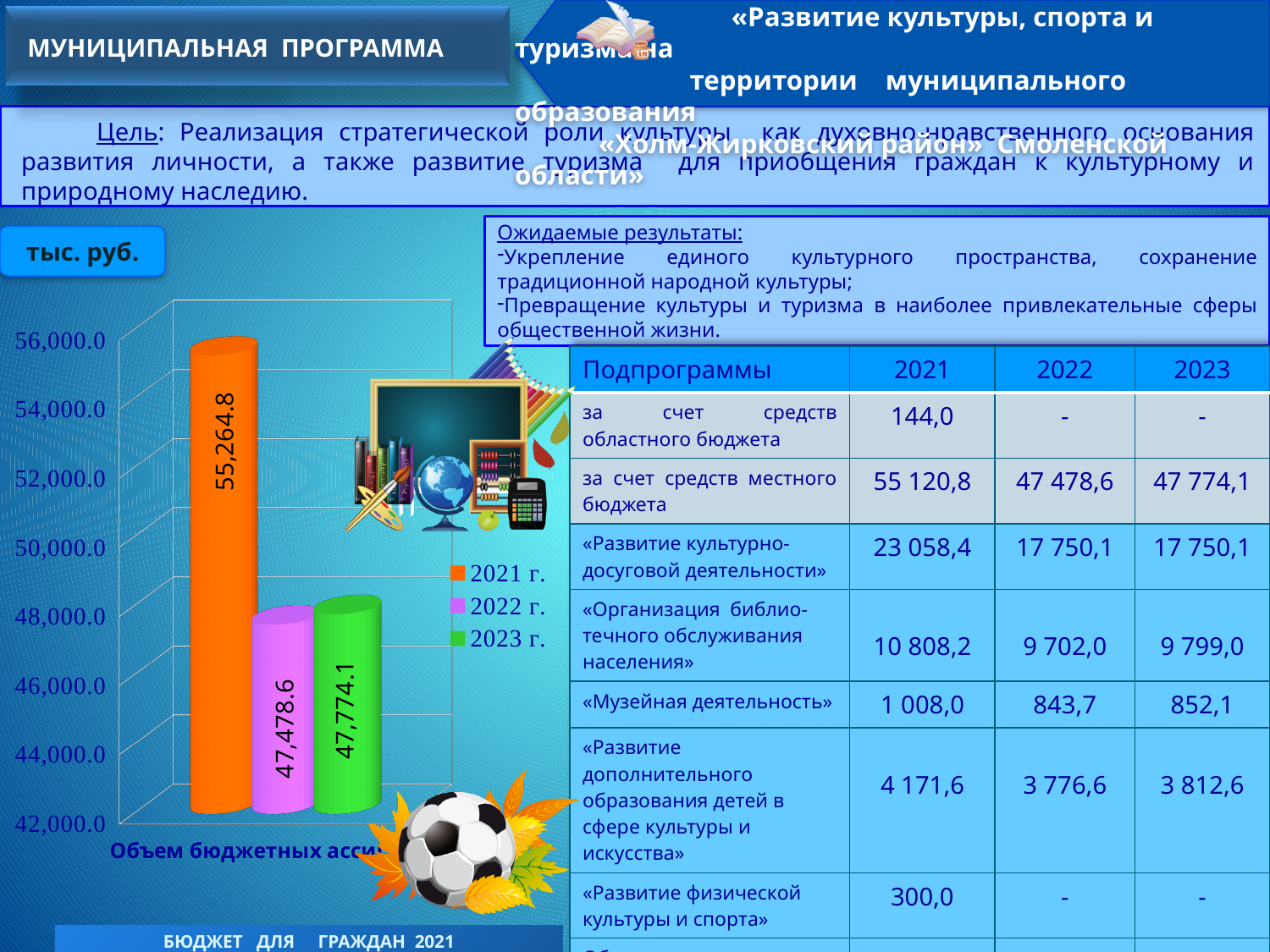
What kind of chart is shown on the slide? bar chart Which is larger, the value for 2022 г. or the value for 2023 г.? 2023 г. What is the value of the bar for 2023 г.? 47,774.1 What is the value of the bar for 2022 г.? 47,478.6 How many entries does the chart legend list? 3 What is the difference between the values for 2021 г. and 2022 г.? 7,786.2 What is the difference between the values for 2023 г. and 2022 г.? 295.5 Which year has the highest bar in the chart? 2021 г. What is the value of the bar for 2021 г.? 55,264.8 How many bars are plotted in the chart? 3 Is the value for 2021 г. greater or less than 54,000.0? greater Which year has the lowest bar in the chart? 2022 г.